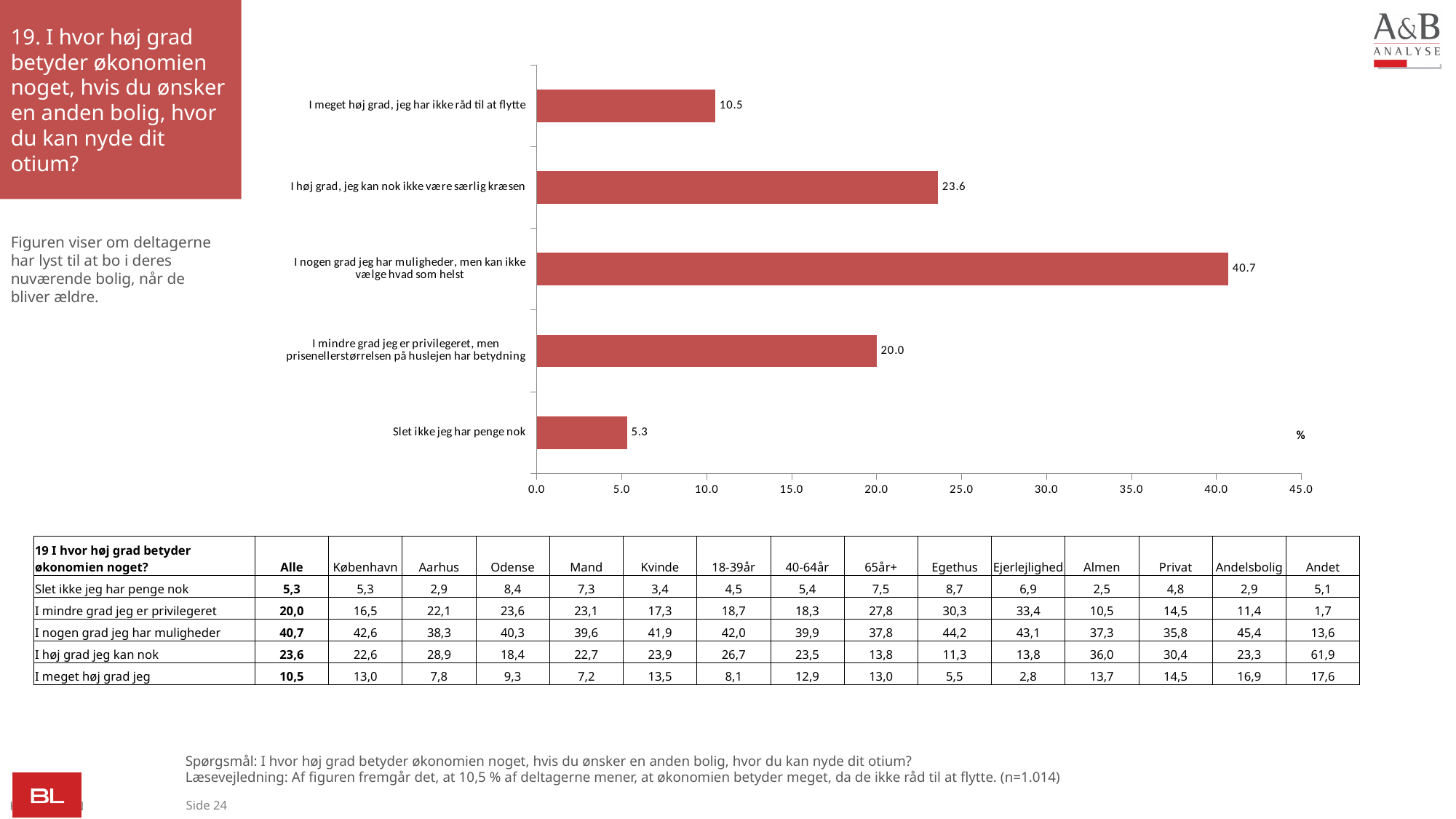
What value is shown for "I mindre grad jeg er privilegeret, men prisen eller størrelsen på huslejen har betydning"? 20.0 What value is shown for "I høj grad, jeg kan nok ikke være særlig kræsen"? 23.6 What kind of chart is shown on the slide? bar chart What value is shown for "Slet ikke jeg har penge nok"? 5.3 What is the maximum value shown on the chart's horizontal axis? 45.0 How many categories are shown in the bar chart? 5 Which category has the lowest value in the chart? Slet ikke jeg har penge nok Is the value for "I nogen grad jeg har muligheder, men kan ikke vælge hvad som helst" greater or less than 35.0? greater Which category has the highest value in the chart? I nogen grad jeg har muligheder, men kan ikke vælge hvad som helst What value is shown for "I meget høj grad, jeg har ikke råd til at flytte"? 10.5 Which is larger: the value for "I meget høj grad, jeg har ikke råd til at flytte" or the value for "I mindre grad jeg er privilegeret, men prisen eller størrelsen på huslejen har betydning"? I mindre grad jeg er privilegeret, men prisen eller størrelsen på huslejen har betydning What is the difference between the values for "I nogen grad jeg har muligheder, men kan ikke vælge hvad som helst" and "I høj grad, jeg kan nok ikke være særlig kræsen"? 17.1